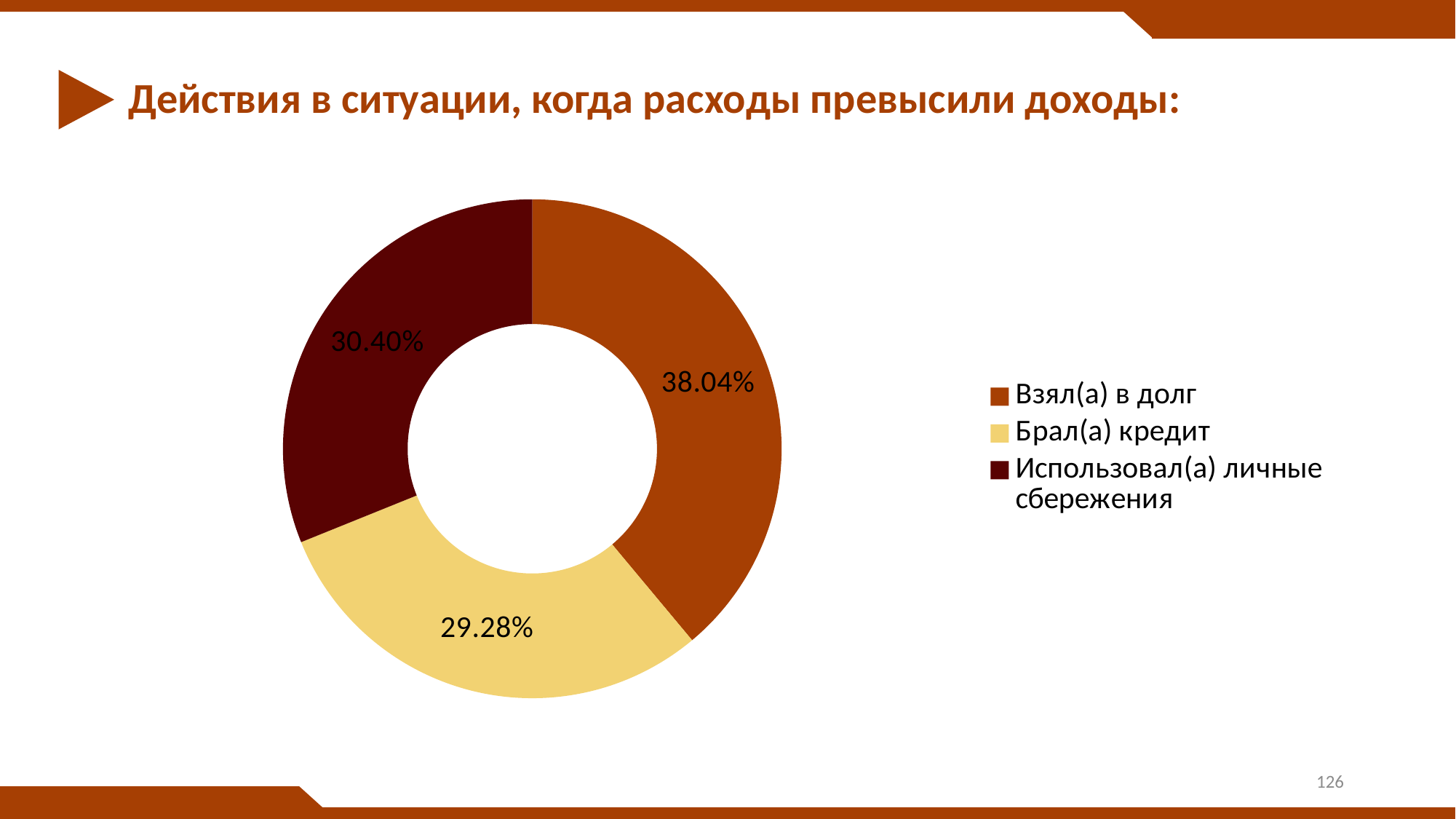
How many categories does the chart show? 3 What share of the chart is labelled for "Брал(а) кредит"? 29.28% What share of the chart is labelled for "Использовал(а) личные сбережения"? 30.40% What is the difference in percentage points between "Взял(а) в долг" and "Брал(а) кредит"? 8.76 Which category has the largest share of the chart? Взял(а) в долг What is the title of the slide above the chart? Действия в ситуации, когда расходы превысили доходы: What is the difference in percentage points between "Использовал(а) личные сбережения" and "Брал(а) кредит"? 1.12 Which colour represents "Брал(а) кредит" in the legend? Light yellow What kind of chart is shown on the slide? Doughnut (pie) chart Which category has the smallest share of the chart? Брал(а) кредит What share of the chart is labelled for "Взял(а) в долг"? 38.04% Which is larger: the share for "Взял(а) в долг" or the share for "Использовал(а) личные сбережения"? Взял(а) в долг